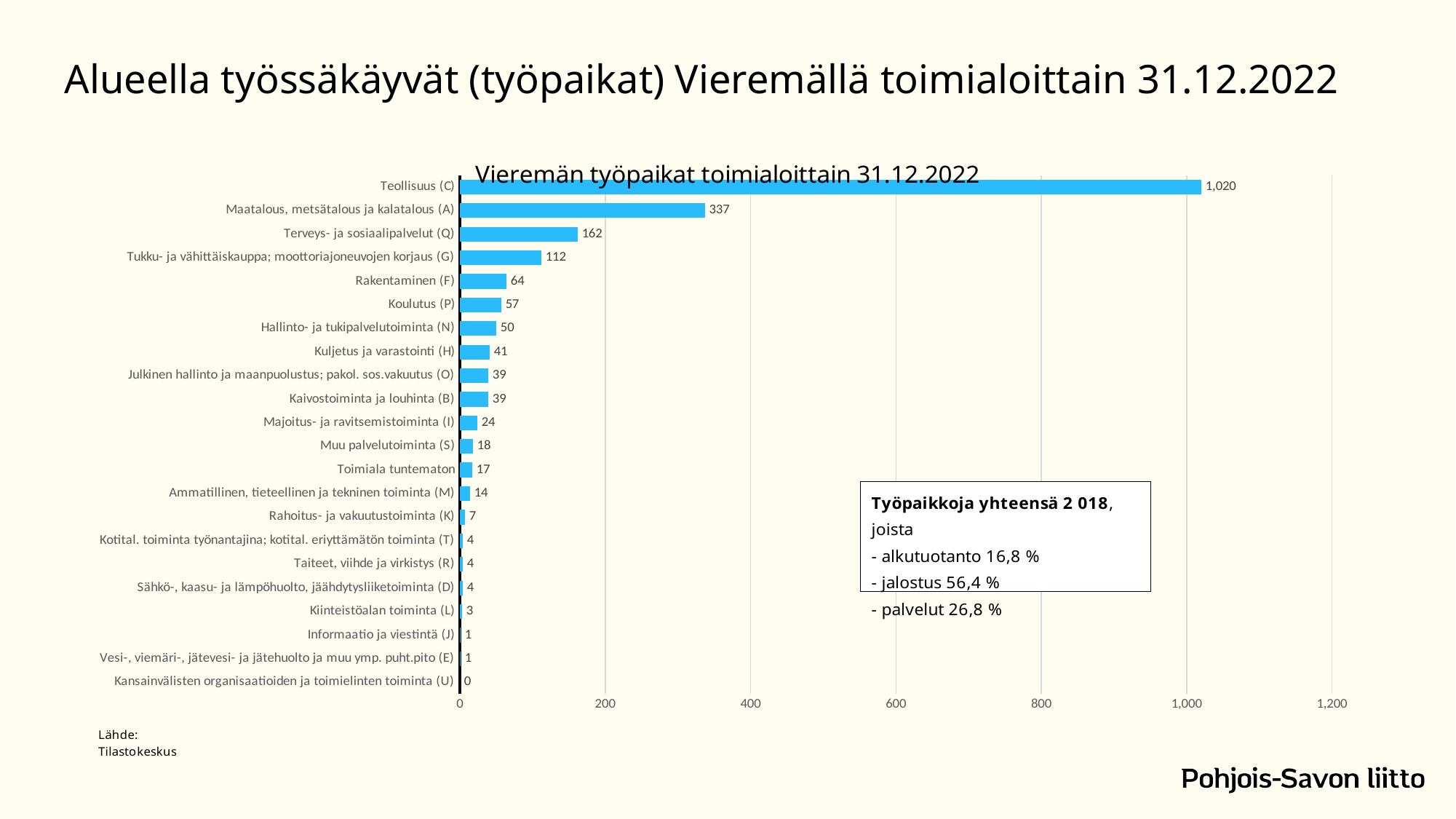
Which is larger, Koulutus (P) or Hallinto- ja tukipalvelutoiminta (N)? Koulutus (P) Which category has the lowest value? Kansainvälisten organisaatioiden ja toimielinten toiminta (U) What is the value for Teollisuus (C)? 1,020 How many categories are shown in the chart? 22 What is the value for Maatalous, metsätalous ja kalatalous (A)? 337 Is the value for Maatalous, metsätalous ja kalatalous (A) greater or less than 400? less Which category has the highest value? Teollisuus (C) What is the title of the chart? Vieremän työpaikat toimialoittain 31.12.2022 What is the value for Rakentaminen (F)? 64 What is the value for Kuljetus ja varastointi (H)? 41 What kind of chart is shown? bar chart What is the difference between Terveys- ja sosiaalipalvelut (Q) and Tukku- ja vähittäiskauppa; moottoriajoneuvojen korjaus (G)? 50